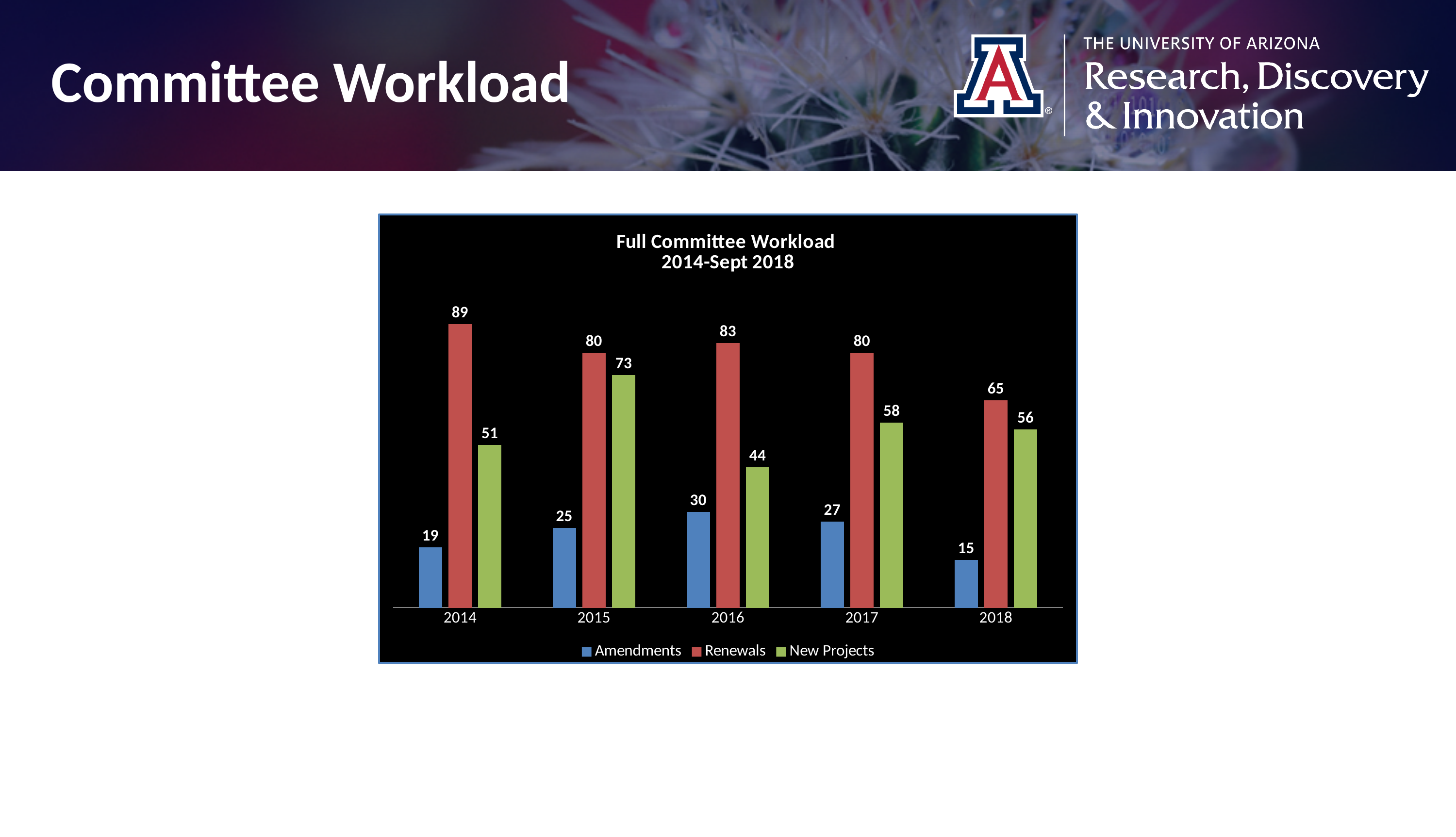
What is the difference between Renewals and New Projects in 2016? 39 Which year has the lowest value for Amendments? 2018 What kind of chart is shown on the slide? Bar chart Do the values for Amendments rise or fall from 2017 to 2018? Fall What is the value for Amendments in 2018? 15 Which is larger in 2017: Amendments or New Projects? New Projects How many years are shown on the x axis? 5 What is the value for New Projects in 2015? 73 Which year has the highest value for Renewals? 2014 How many series does the legend list? 3 What is the value for Renewals in 2014? 89 What is the title of the chart? Full Committee Workload 2014-Sept 2018